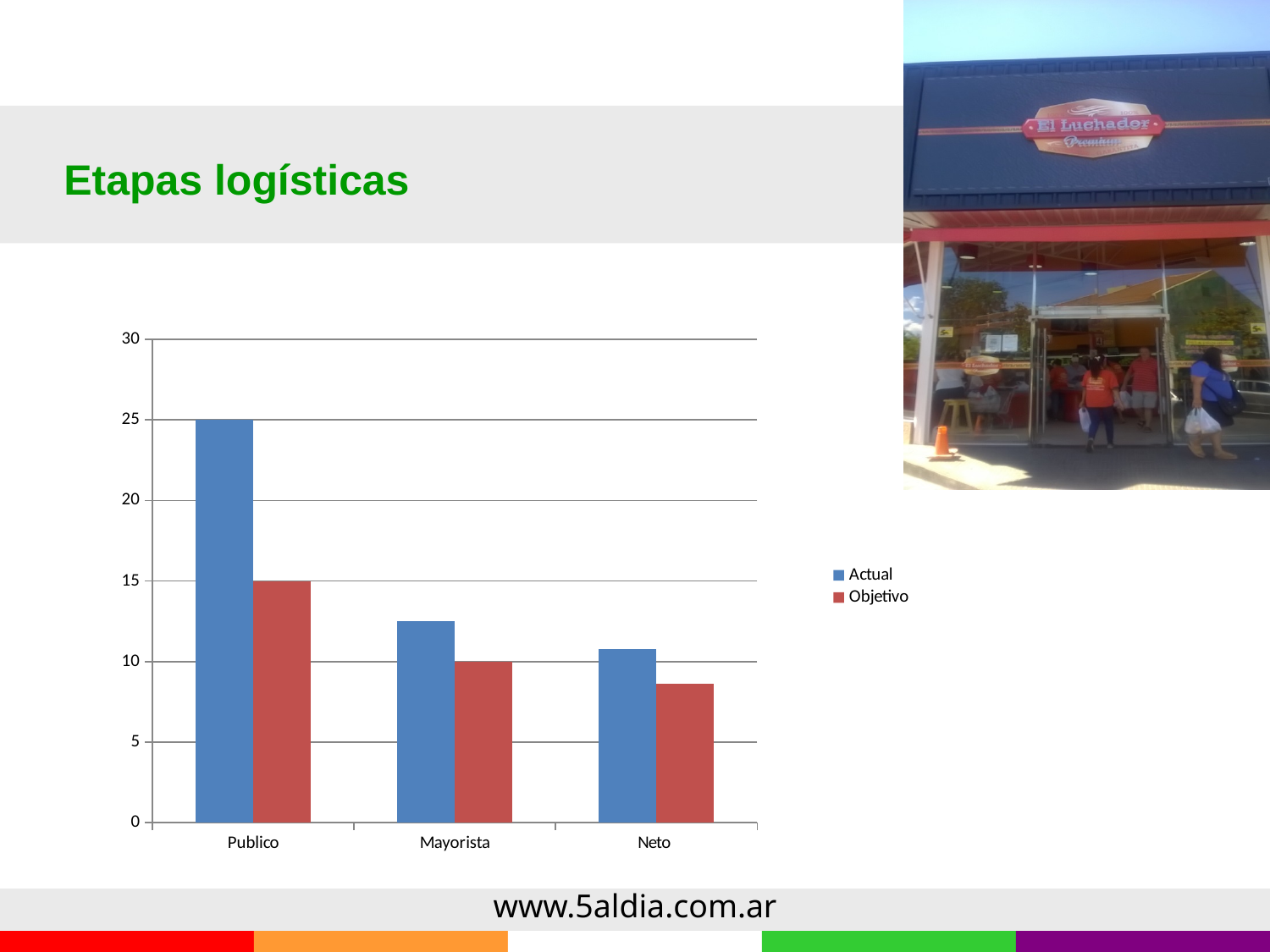
What is the Objetivo value for Publico? 15 Which category has the highest Actual value? Publico Is the Actual value for Mayorista greater or less than 10? greater What kind of chart is shown on the slide? bar chart What is the Objetivo value for Mayorista? 10 How many categories are shown on the x axis? 3 Do the Actual values rise or fall from Publico to Neto? fall For Publico, which is larger, Actual or Objetivo? Actual Which category has the lowest Objetivo value? Neto How many series does the legend list? 2 What is the Actual value for Publico? 25 What is the difference between the Actual and Objetivo values for Publico? 10